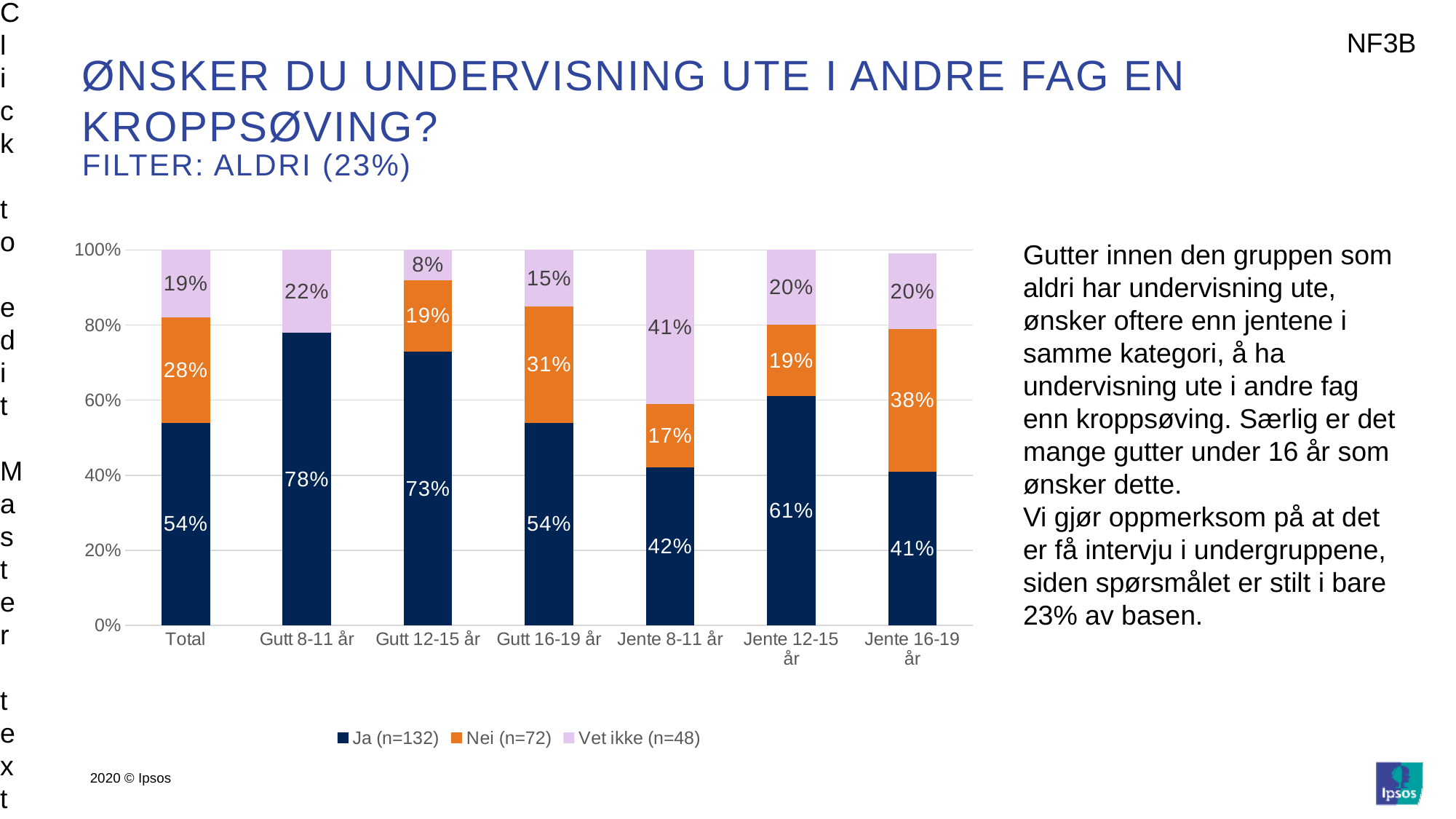
Which is larger, the 'Nei' value for Gutt 16-19 år or for Jente 8-11 år? Gutt 16-19 år What is the 'Nei' value for Jente 16-19 år? 38% How many categories are shown on the x axis of the chart? 7 What kind of chart is shown on the slide? Stacked bar chart How many series does the chart legend list? 3 What is the 'Vet ikke' value for Jente 8-11 år? 41% What is the sample size (n) shown in the legend for the 'Ja' series? 132 Which category has the highest 'Ja' value? Gutt 8-11 år Is the 'Nei' value for Gutt 8-11 år greater or less than 20%? less What is the 'Ja' value for Gutt 8-11 år? 78% What is the difference between the 'Ja' values for Gutt 12-15 år and Jente 12-15 år? 12% Which category has the lowest 'Vet ikke' value? Gutt 12-15 år